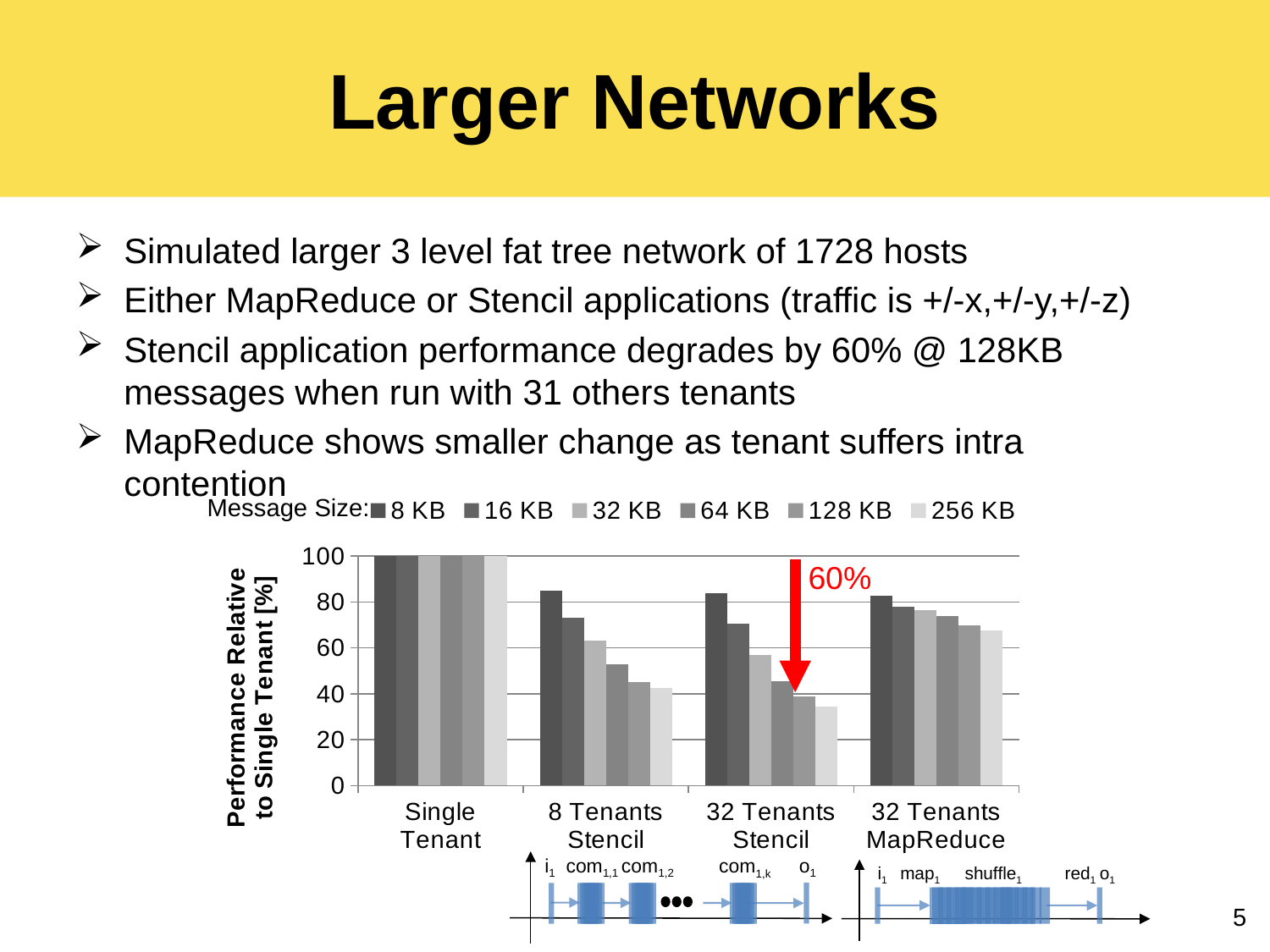
How many tenant configurations are shown along the x axis? 4 Is the value for 8 KB messages with 8 Tenants Stencil greater or less than 80? greater What is the y-axis label of the chart? Performance Relative to Single Tenant [%] What is the performance relative to single tenant for the 8 KB message size in the Single Tenant configuration? 100 Is the value for 256 KB messages with 32 Tenants MapReduce greater or less than 60? greater How many message sizes does the legend list? 6 Which configuration has the highest performance relative to single tenant across all message sizes? Single Tenant Is the value for 256 KB messages with 32 Tenants Stencil greater or less than 40? less Within the 8 Tenants Stencil group, do the values rise or fall as message size increases from 8 KB to 256 KB? fall What kind of chart is shown on the slide? bar chart For 256 KB messages, which is larger: the value for 32 Tenants Stencil or 32 Tenants MapReduce? 32 Tenants MapReduce Which message size is shown by the lightest bar in the legend? 256 KB